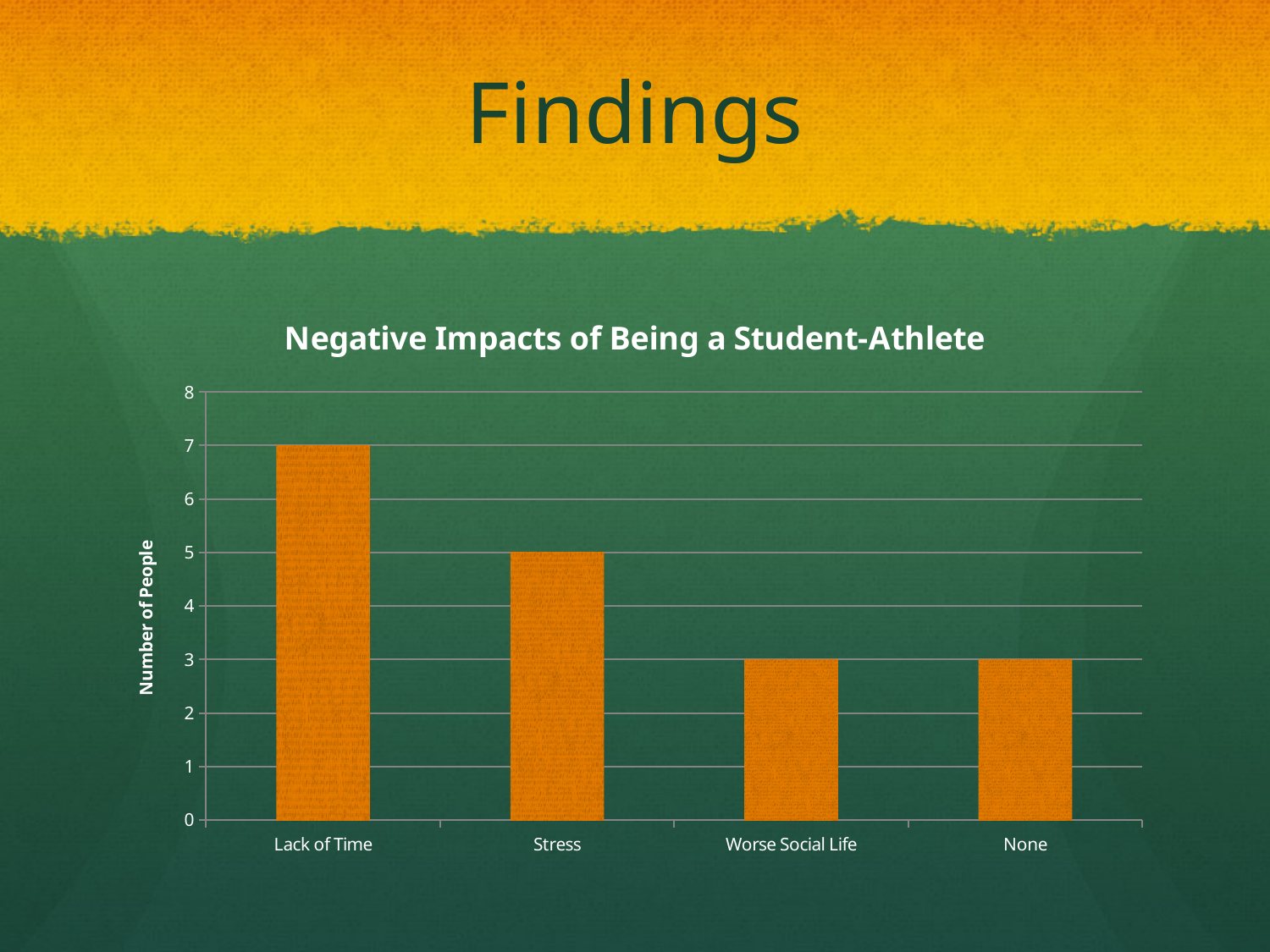
What is the difference between the values for Lack of Time and Stress? 2 What is the difference between the values for Stress and Worse Social Life? 2 Is the value for Lack of Time greater or less than 6? greater What is the value for Worse Social Life? 3 What is the value for None? 3 How many categories are shown on the x axis? 4 What kind of chart is shown on the slide? bar chart What is the value for Lack of Time? 7 What is the value for Stress? 5 Which is larger, the value for Stress or the value for None? Stress What is the title of the chart? Negative Impacts of Being a Student-Athlete Which category has the highest number of people? Lack of Time